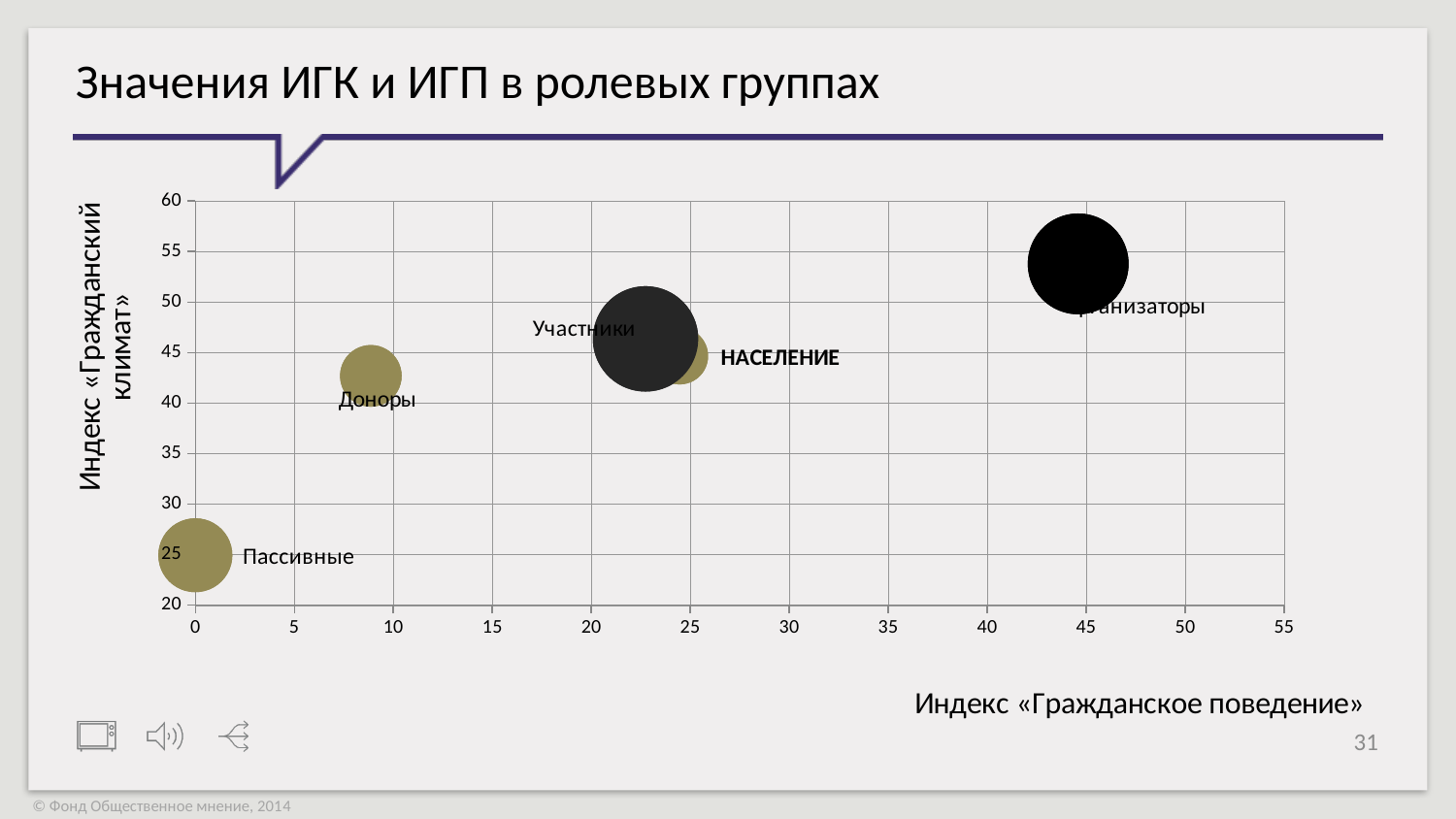
Is the vertical-axis value for Пассивные greater or less than 30? less Which group has a higher vertical-axis value, Доноры or Пассивные? Доноры How many labelled groups (bubbles) are plotted on the chart? 5 Which group has the lowest value on the horizontal axis (Индекс «Гражданское поведение»)? Пассивные Is the horizontal-axis value for Доноры greater or less than 15? less Which group has the highest value on the vertical axis (Индекс «Гражданский климат»)? Организаторы Is the vertical-axis value for Организаторы greater or less than 50? greater What is the title of the chart on the slide? Значения ИГК и ИГП в ролевых группах What kind of chart is shown on the slide? Bubble chart Which group has the highest value on the horizontal axis (Индекс «Гражданское поведение»)? Организаторы Which group has the lowest value on the vertical axis (Индекс «Гражданский климат»)? Пассивные